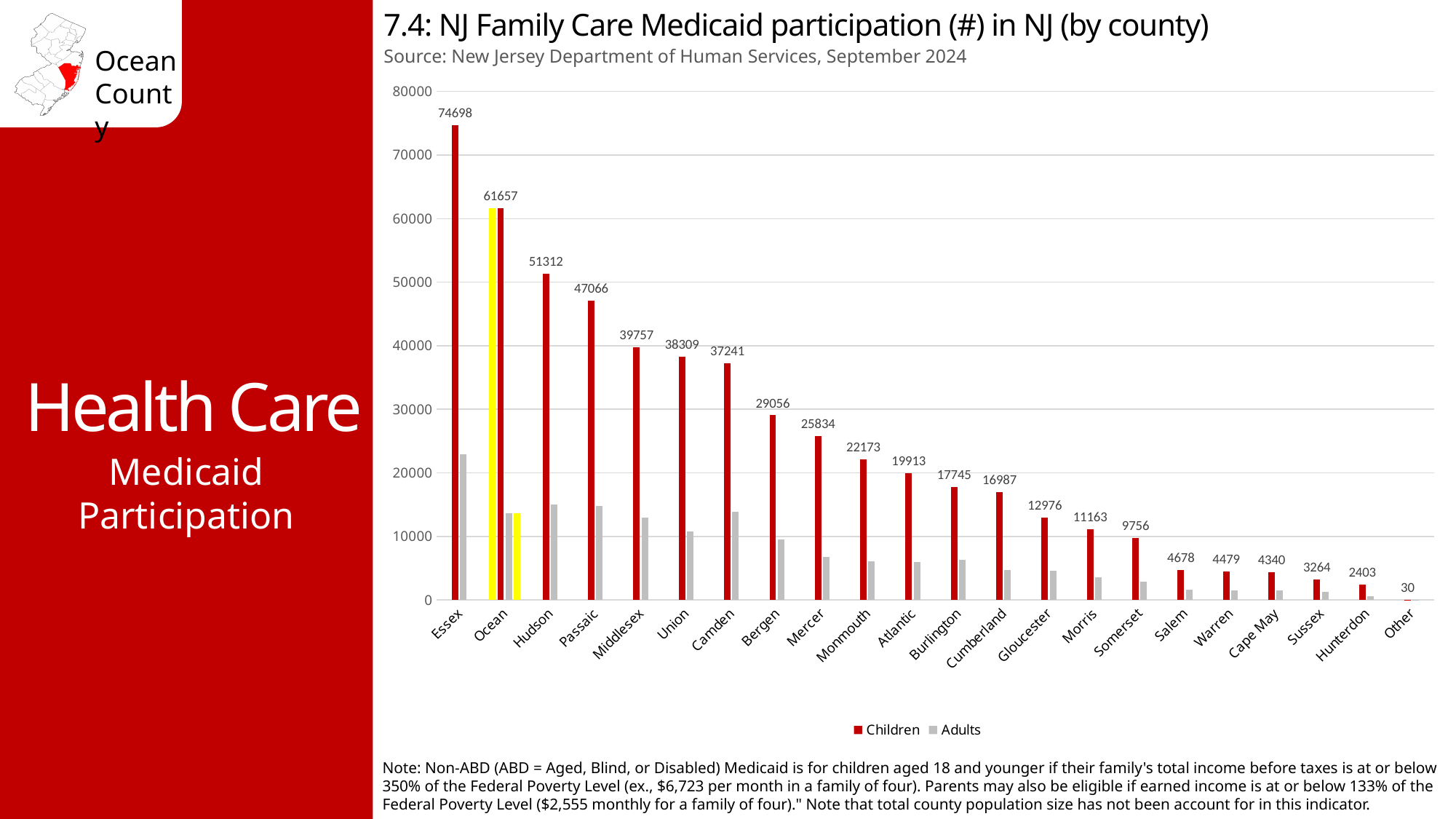
What kind of chart is shown on the slide? Bar chart Which has a larger Children value, Hudson or Passaic? Hudson How many categories are shown on the x axis? 22 What is the Children value for Ocean? 61657 What is the Children value for Monmouth? 22173 What is the Children value for Essex? 74698 How many series does the legend list? 2 Is the Adults value for Essex greater or less than 20000? greater Which category has the lowest Children value? Other What is the difference between the Children values for Essex and Ocean? 13041 Which county has the highest Children value? Essex Is the Adults value for Hudson greater or less than 20000? less